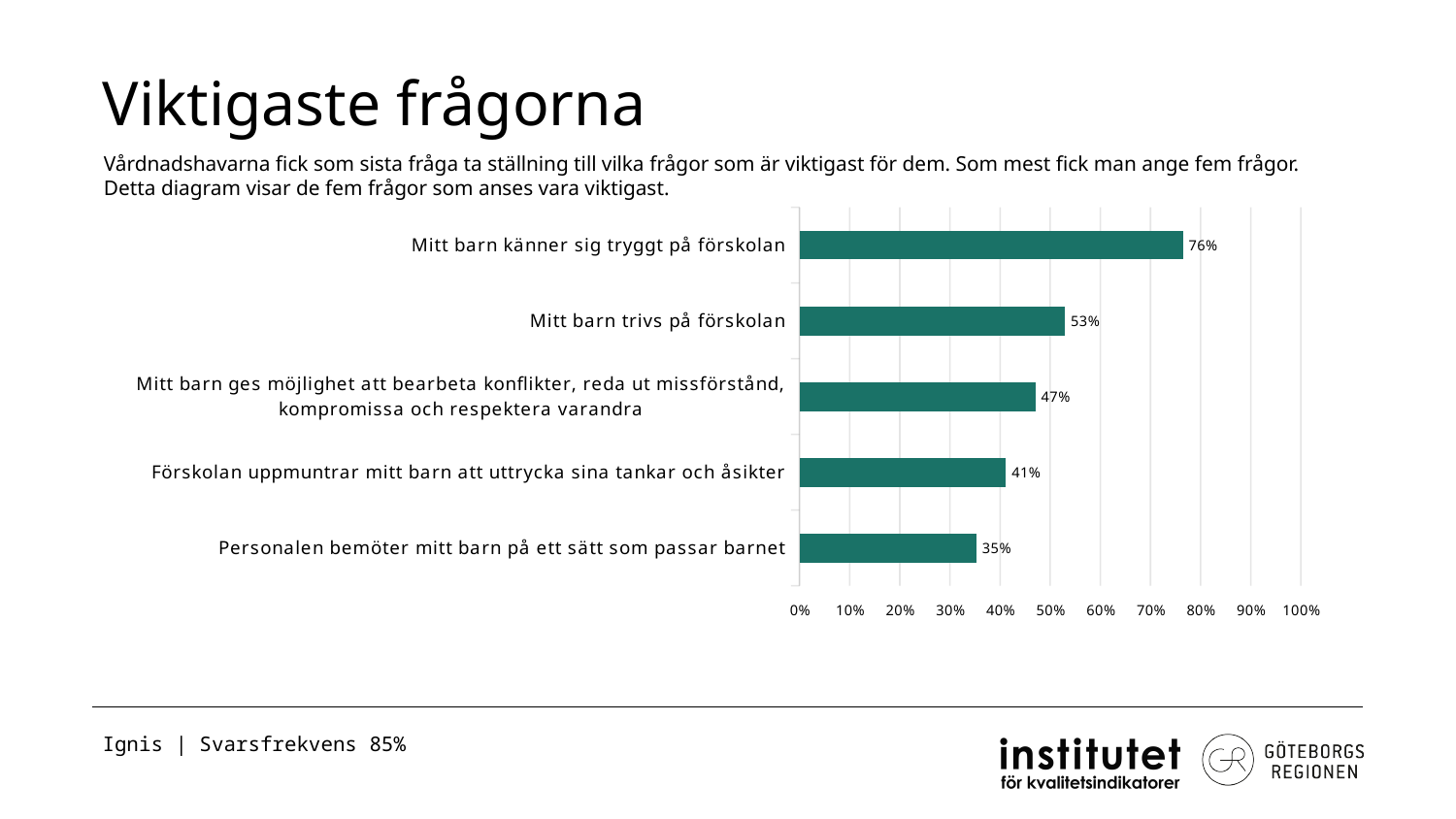
Which is larger: the value for "Mitt barn ges möjlighet att bearbeta konflikter, reda ut missförstånd, kompromissa och respektera varandra" or the value for "Förskolan uppmuntrar mitt barn att uttrycka sina tankar och åsikter"? Mitt barn ges möjlighet att bearbeta konflikter, reda ut missförstånd, kompromissa och respektera varandra Which category has the lowest value? Personalen bemöter mitt barn på ett sätt som passar barnet What is the value for "Personalen bemöter mitt barn på ett sätt som passar barnet"? 35% Is the value for "Mitt barn trivs på förskolan" greater or less than 50%? greater How many categories are shown in the chart? 5 What is the value for "Mitt barn trivs på förskolan"? 53% What is the difference between the values for "Mitt barn känner sig tryggt på förskolan" and "Mitt barn trivs på förskolan"? 23% What is the value for "Förskolan uppmuntrar mitt barn att uttrycka sina tankar och åsikter"? 41% Which category has the highest value? Mitt barn känner sig tryggt på förskolan What kind of chart is shown on the slide? Bar chart What is the title of the slide containing the chart? Viktigaste frågorna What is the value for "Mitt barn känner sig tryggt på förskolan"? 76%